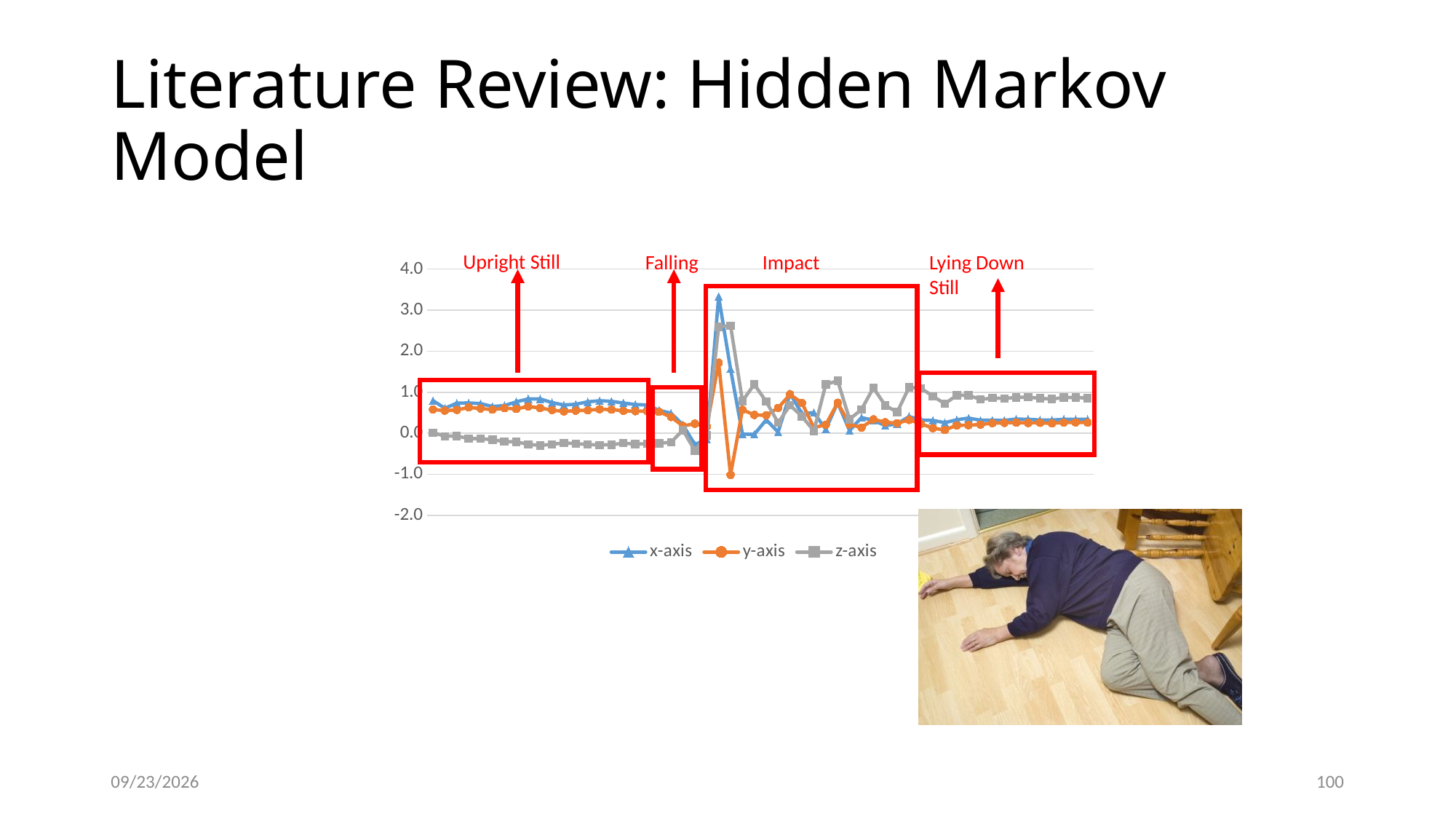
During the Lying Down Still phase, are the z-axis values greater or less than 0.0? greater What kind of chart is shown on the slide? line chart Is the peak value of the x-axis series greater or less than 3.0? greater During the Upright Still phase, are the z-axis values greater or less than 0.0? less Which series drops to the lowest value during the Impact phase? y-axis Which series reaches the highest peak during the Impact phase? x-axis What are the three series named in the legend? x-axis, y-axis, z-axis How many labelled phases (red boxes) are marked on the chart? 4 In the Lying Down Still phase, which series is higher: z-axis or y-axis? z-axis What is the highest value shown on the vertical axis? 4.0 How many series does the chart's legend list? 3